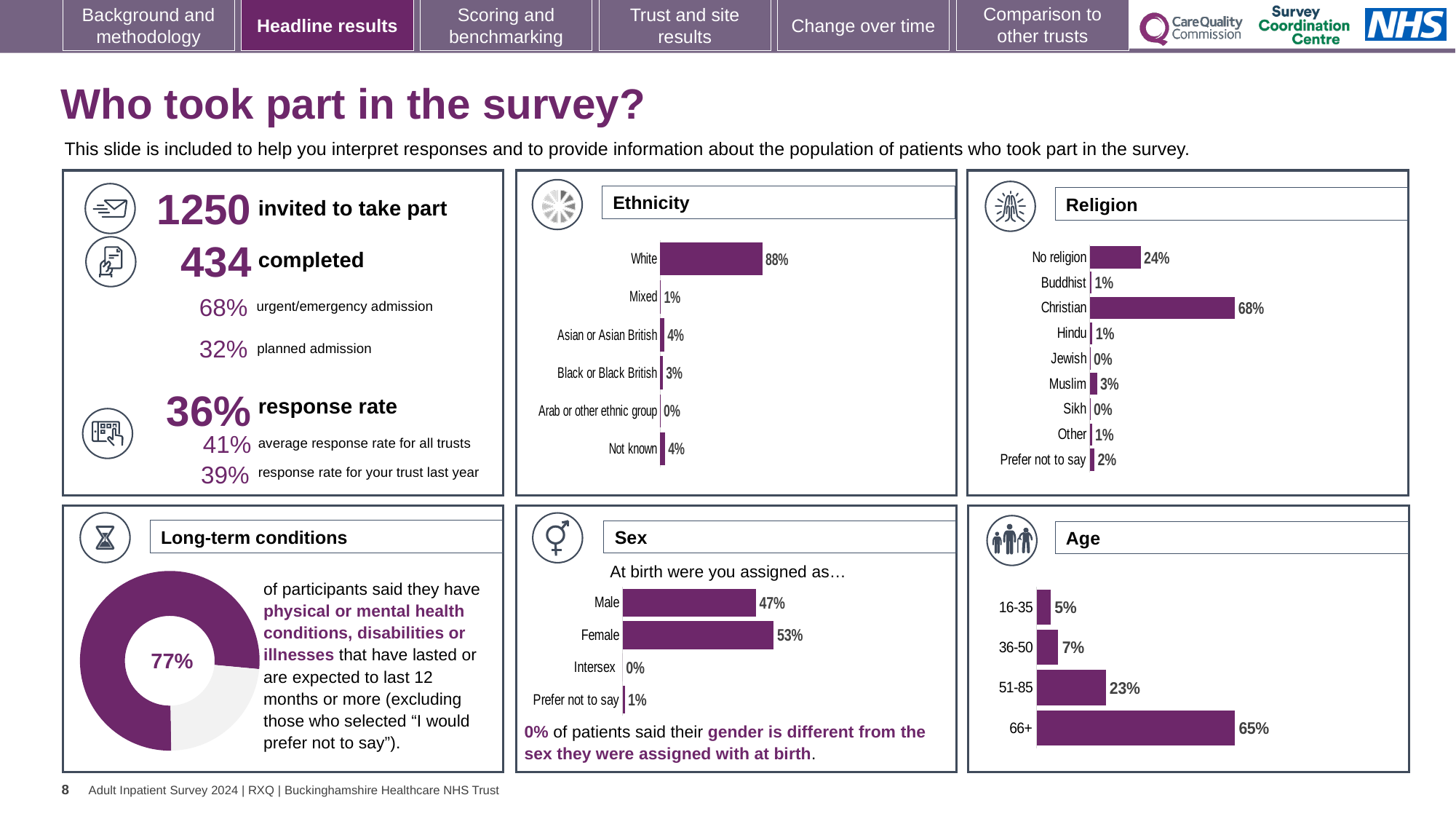
In the Ethnicity chart, what is the value for White? 88% In the Age chart, do the values rise or fall from 16-35 to 66+? Rise How many categories does the Religion chart show? 9 What kind of chart is the Long-term conditions chart? Doughnut chart In the Age chart, what is the difference between the 66+ and 51-85 values? 42% In the Sex chart, what is the value for Prefer not to say? 1% In the Sex chart, which is larger, Male or Female? Female In the Ethnicity chart, what is the value for Black or Black British? 3% In the Religion chart, which category has the highest value? Christian In the Religion chart, what is the value for No religion? 24% How many categories does the Ethnicity chart show? 6 In the Long-term conditions chart, what share of participants said they have physical or mental health conditions, disabilities or illnesses? 77%